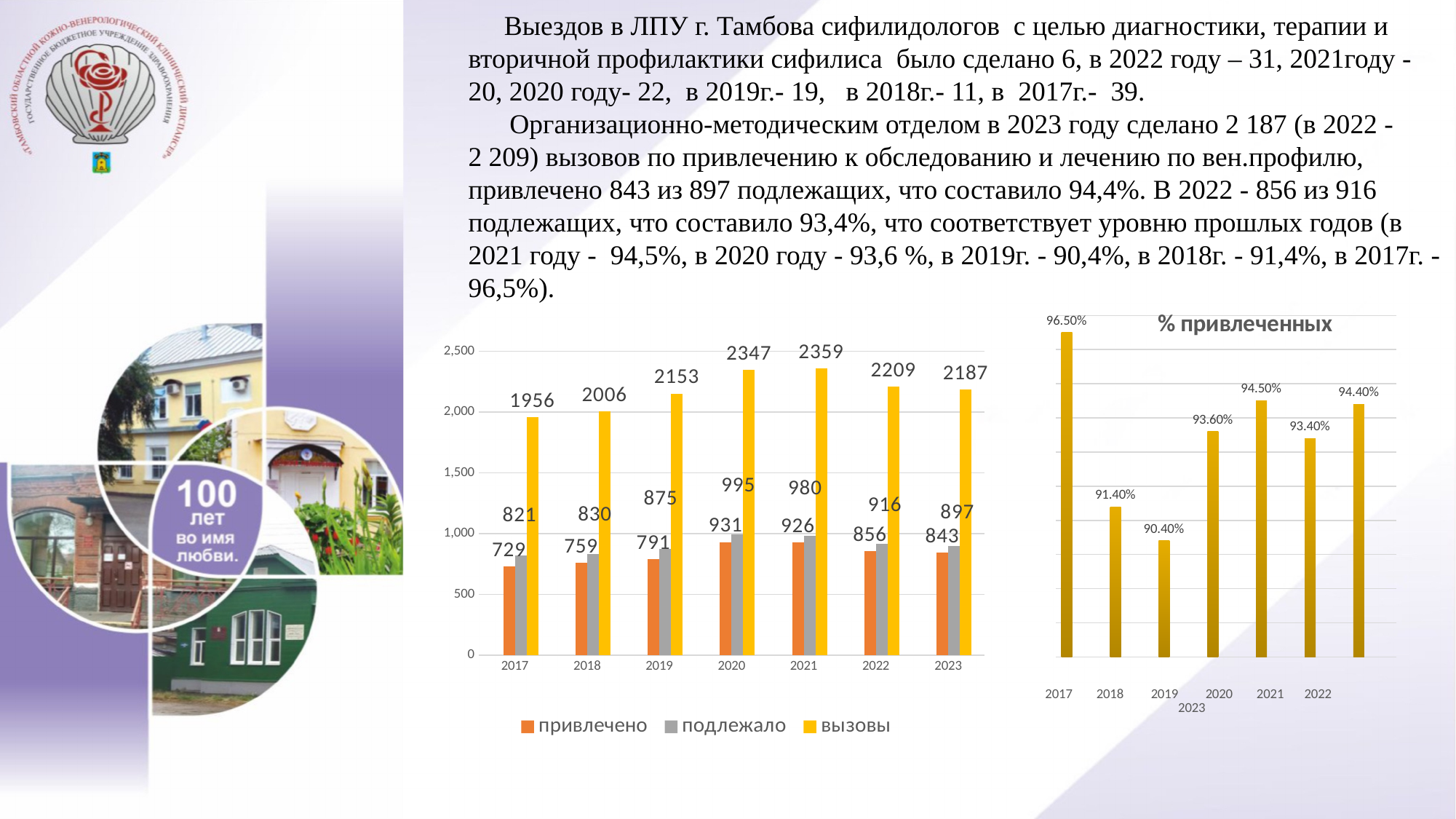
In the left chart, what is the value of подлежало for 2023? 897 What type of chart is the chart titled '% привлеченных'? bar chart In the left chart, which series is shown in yellow? вызовы In the left chart, what is the value of вызовы for 2021? 2359 In the left chart, which year has the lowest value of привлечено? 2017 In the chart titled '% привлеченных', which year has the highest value? 2017 In the left chart, what is the value of привлечено for 2020? 931 In the chart titled '% привлеченных', what is the value for 2019? 90.40% In the left chart, which year has the highest value of вызовы? 2021 In the chart titled '% привлеченных', is the value for 2021 larger or smaller than the value for 2022? larger In the left chart, what is the difference between подлежало and привлечено in 2023? 54 In the left chart, how many series does the legend list? 3